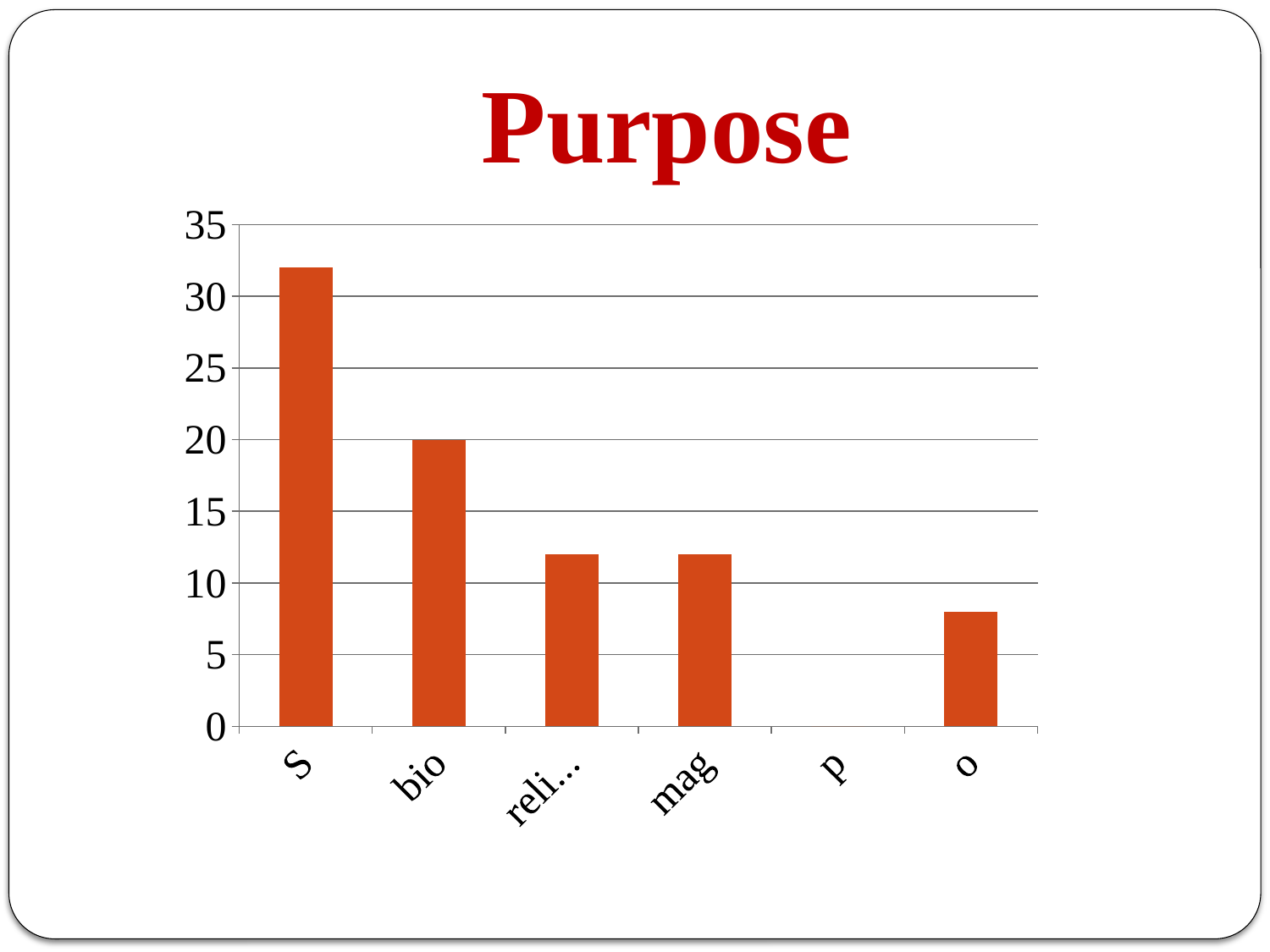
What is the value for bio in the chart? 20 Is the value for reli... greater or less than 10? greater How many categories are shown on the x axis of the chart? 6 Which category has the highest bar in the chart? S Is the value for o greater or less than 10? less What is the title of the slide containing the chart? Purpose Is the value for mag greater or less than 15? less Which is larger, the value for bio or the value for o? bio What kind of chart is shown on the slide? bar chart Which is larger, the value for S or the value for bio? S Which category has the lowest value in the chart? p